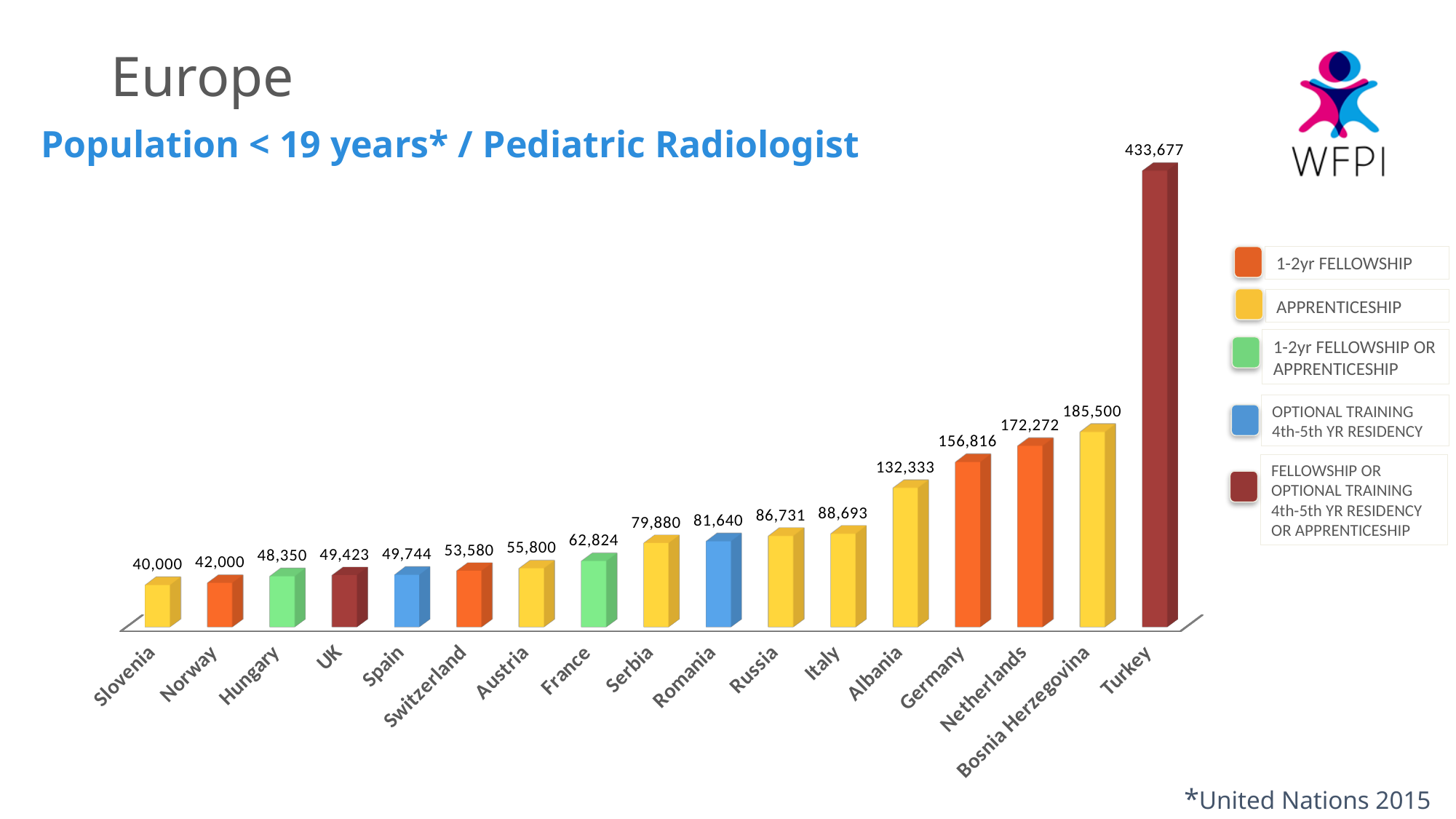
How many countries are shown on the chart? 17 What is the value shown for Switzerland? 53,580 Do the values rise or fall from left to right along the x axis? Rise What is the difference between the values for Turkey and Bosnia Herzegovina? 248,177 Which country has the lowest value on the chart? Slovenia What is the value shown for Romania? 81,640 What kind of chart is shown on the slide? Bar chart Which has a larger value, Albania or Italy? Albania Which country has the highest value on the chart? Turkey How many entries does the legend list? 5 What is the value shown for Germany? 156,816 What is the difference between the values for Norway and Slovenia? 2,000